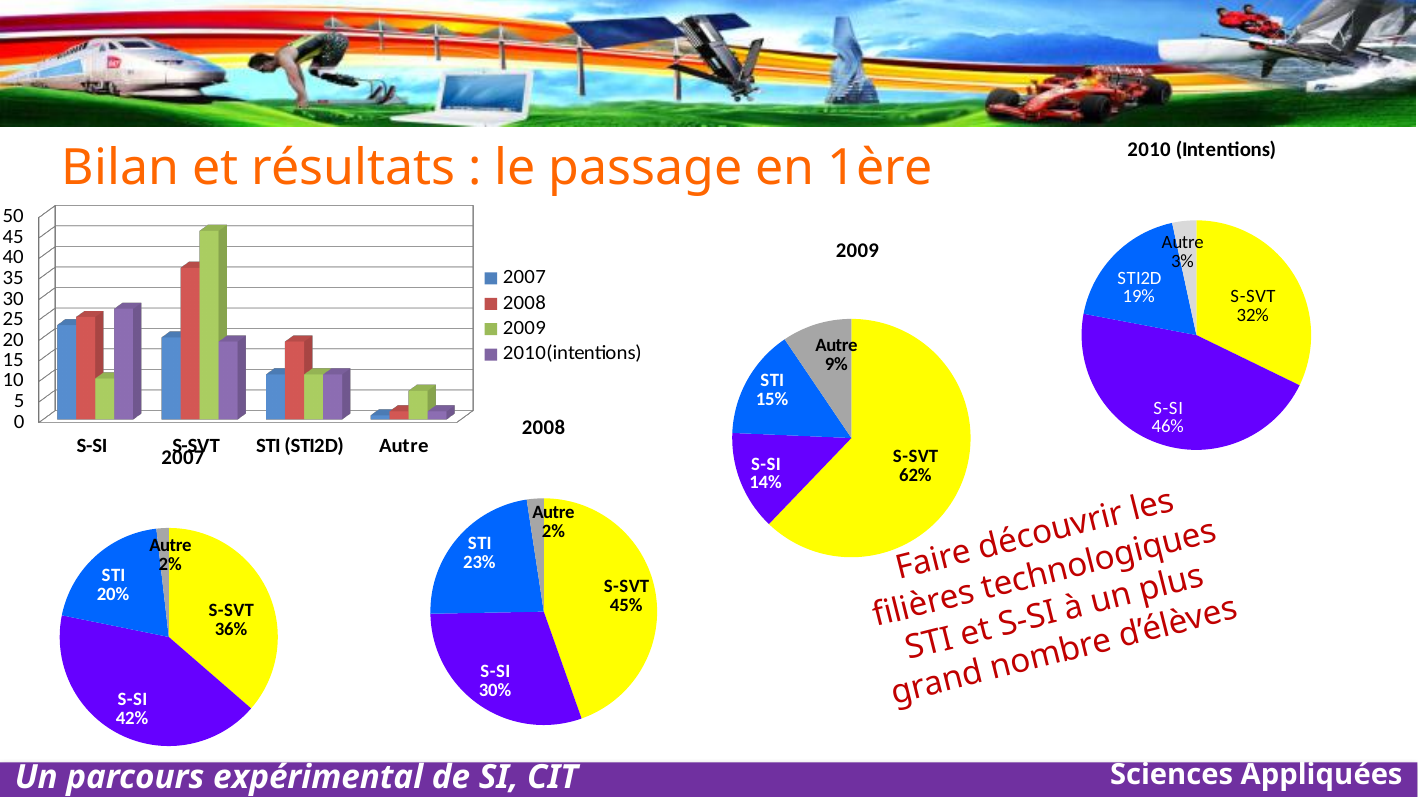
In the 2009 pie chart, which is larger, the STI share or the S-SI share? STI In the bar chart, which category has the lowest values across all series? Autre In the bar chart, is the 2009 value for S-SVT greater or less than 40? greater In the 2007 pie chart, what share does S-SI have? 42% What kind of chart is the chart at the top left of the slide? bar chart In the bar chart, which series has the highest value for S-SVT? 2009 In the bar chart, how many categories are shown on the x axis? 4 In the bar chart, is the 2009 value for S-SI greater or less than 15? less In the 2008 pie chart, what share does STI have? 23% In the 2010 (Intentions) pie chart, what is the difference between the S-SI share and the S-SVT share? 14% In the bar chart, how many series does the legend list? 4 In the 2009 pie chart, which slice is the largest? S-SVT